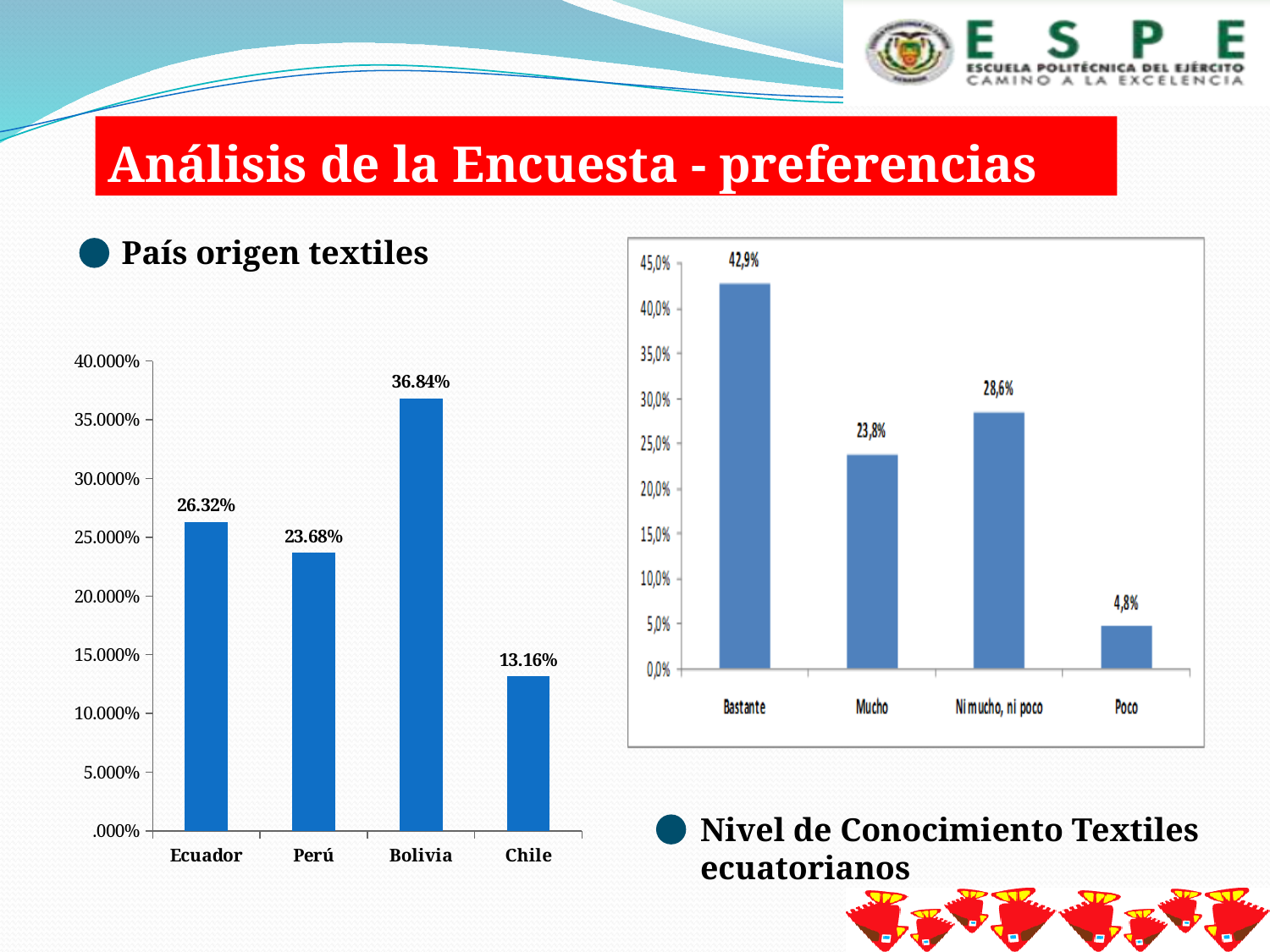
What kind of chart is the 'Nivel de Conocimiento Textiles ecuatorianos' chart on the right? Bar chart In the 'Nivel de Conocimiento Textiles ecuatorianos' chart on the right, what is the difference between the values for Bastante and Poco? 38,1% In the 'País origen textiles' chart on the left, which country has the highest value? Bolivia In the 'Nivel de Conocimiento Textiles ecuatorianos' chart on the right, which category has the lowest value? Poco In the 'País origen textiles' chart on the left, what is the difference between the values for Bolivia and Chile? 23.68% How many countries are shown in the 'País origen textiles' chart on the left? 4 In the 'País origen textiles' chart on the left, which country has the lowest value? Chile In the 'Nivel de Conocimiento Textiles ecuatorianos' chart on the right, what is the value for 'Ni mucho, ni poco'? 28,6% In the 'País origen textiles' chart on the left, what is the value for Chile? 13.16% In the 'País origen textiles' chart on the left, what is the value for Bolivia? 36.84% In the 'Nivel de Conocimiento Textiles ecuatorianos' chart on the right, what is the value for Bastante? 42,9% In the 'País origen textiles' chart on the left, which is larger, the value for Ecuador or the value for Perú? Ecuador